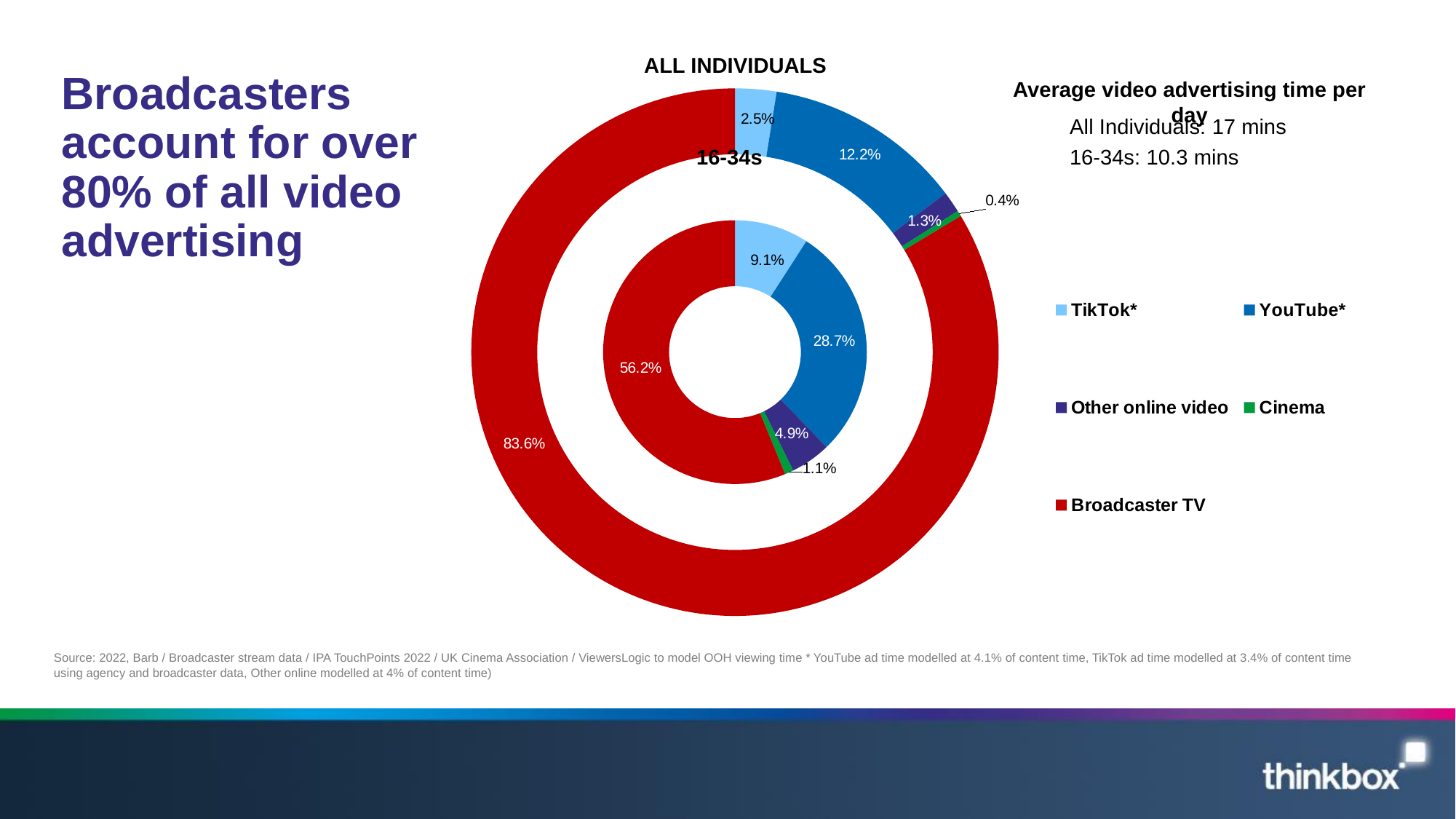
How many categories does the legend of the doughnut chart list? 5 In the doughnut chart, what is the YouTube* share in the 16-34s ring? 28.7% In the doughnut chart, is the TikTok* share larger for ALL INDIVIDUALS or for 16-34s? 16-34s In the doughnut chart, which category has the largest share in the 16-34s ring? Broadcaster TV According to the text on the slide, what is the average video advertising time per day for 16-34s? 10.3 mins In the doughnut chart, which category has the smallest share in the ALL INDIVIDUALS ring? Cinema In the doughnut chart, what share of video advertising does Broadcaster TV account for in the ALL INDIVIDUALS ring? 83.6% In the doughnut chart, what is the Cinema share in the 16-34s ring? 1.1% What type of chart is shown on the slide? Doughnut chart In the doughnut chart, what is the Other online video share for ALL INDIVIDUALS? 1.3% In the doughnut chart, what is the TikTok* share for ALL INDIVIDUALS? 2.5% In the doughnut chart, what is the difference between the Broadcaster TV share for ALL INDIVIDUALS and for 16-34s? 27.4%